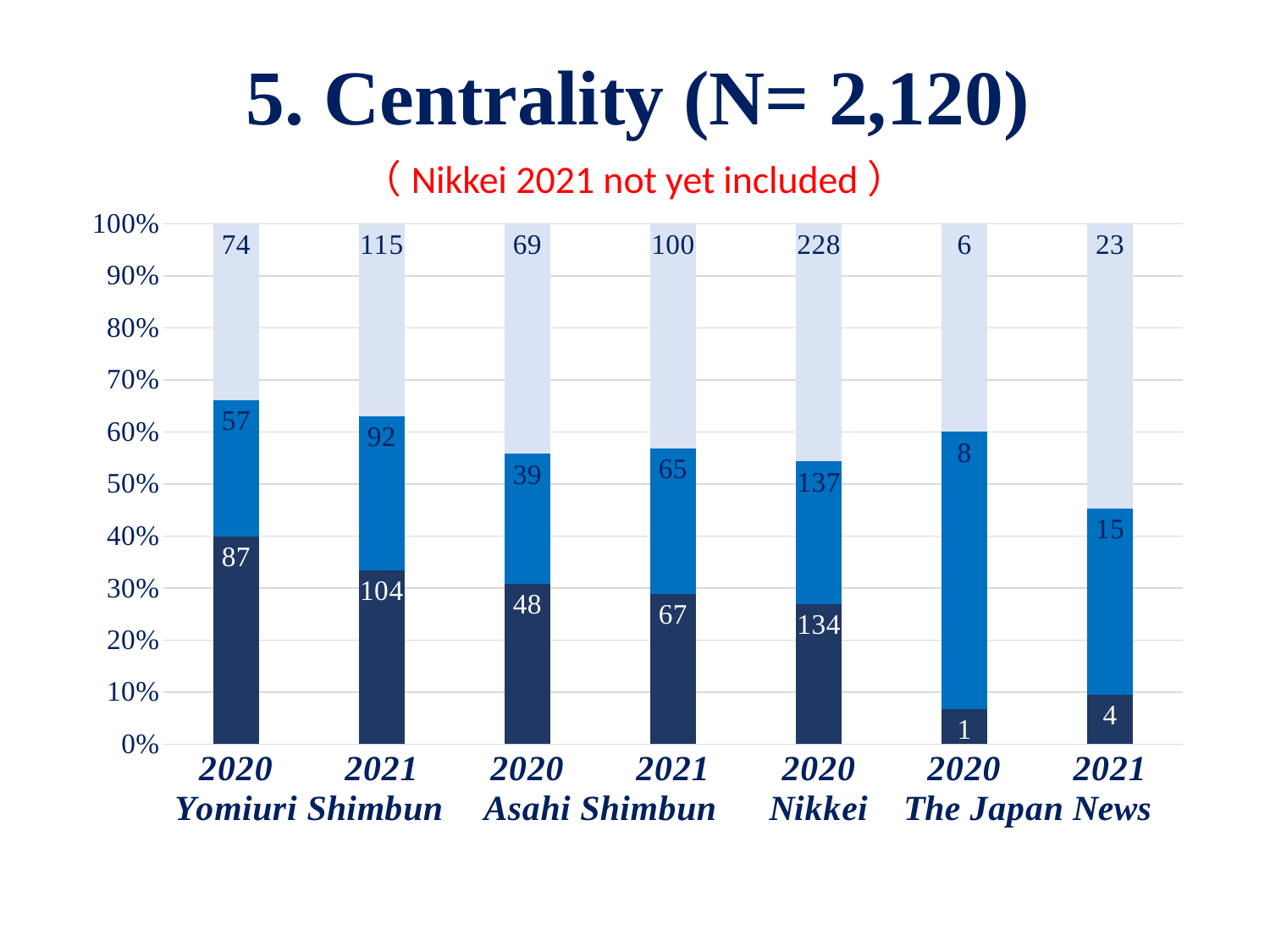
What is the value labelled on the bottom (dark navy) segment of the 2020 Yomiuri Shimbun bar? 87 Which bar has the largest value labelled on its top (light blue) segment? 2020 Nikkei What kind of chart is shown on the slide? stacked bar chart Which bar has the smallest value labelled on its bottom (dark navy) segment? 2020 The Japan News According to the red subtitle, which newspaper-year is not yet included in the chart? Nikkei 2021 Which is larger: the middle-segment value for 2021 Yomiuri Shimbun or for 2020 Asahi Shimbun? 2021 Yomiuri Shimbun Is the share of the bottom (dark navy) segment in the 2020 Nikkei bar greater or less than 30%? less What is the difference between the bottom-segment values of the 2021 Yomiuri Shimbun bar (104) and the 2020 Yomiuri Shimbun bar (87)? 17 How many bars are plotted in the chart? 7 What is the total of the three labelled values in the 2021 The Japan News bar? 42 What is the value labelled on the middle (medium blue) segment of the 2021 Asahi Shimbun bar? 65 What is the value labelled on the top (light blue) segment of the 2020 Nikkei bar? 228